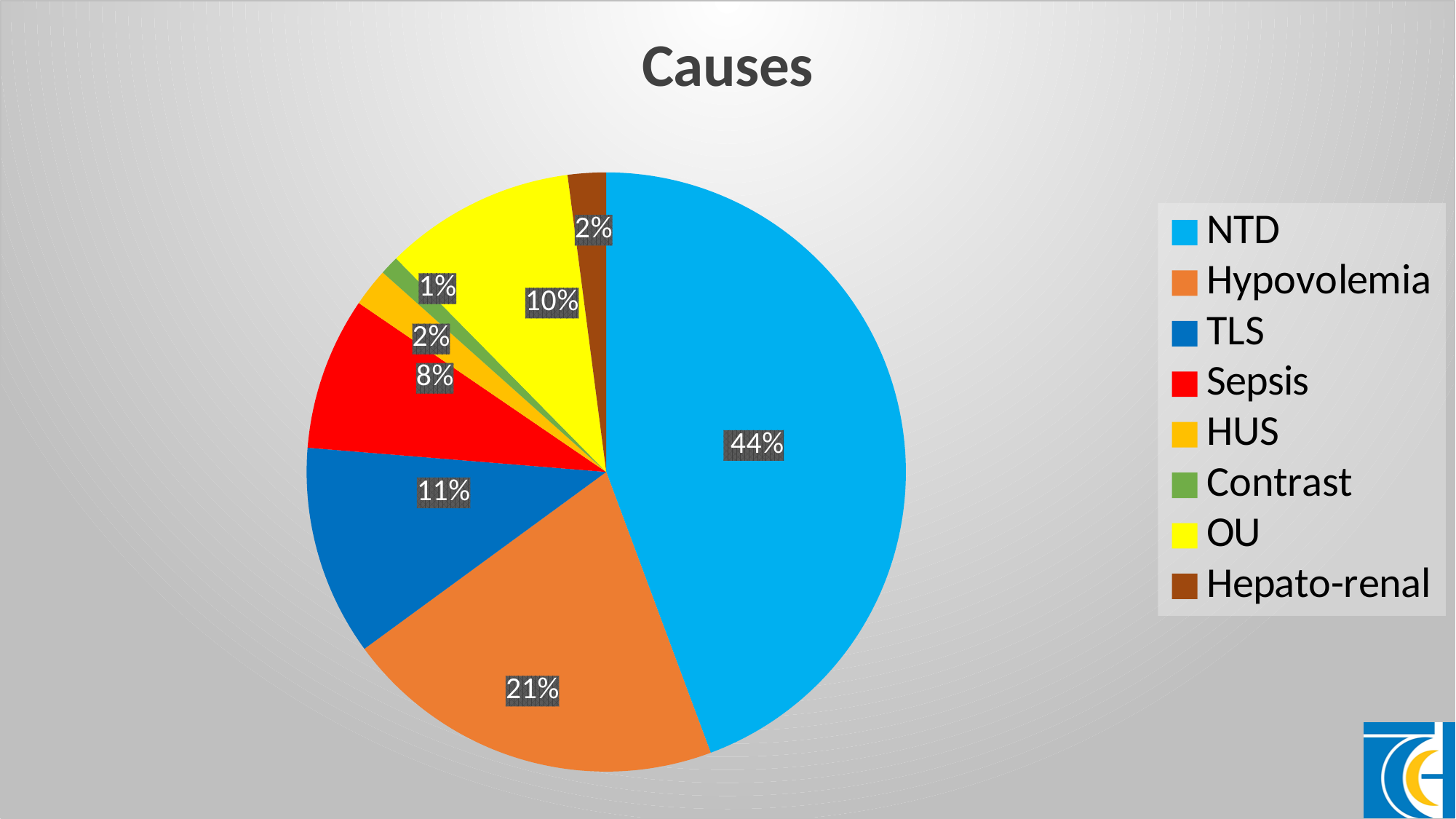
What type of chart is shown on the slide? pie chart What is the title of the chart? Causes What percentage is shown for Hypovolemia? 21% What percentage is shown for TLS? 11% What percentage is shown for OU? 10% Which has a larger share, TLS or OU? TLS What share of the pie does NTD account for? 44% Which cause has the largest share of the pie? NTD Which cause has the smallest share of the pie? Contrast What percentage is shown for Sepsis? 8% What is the difference in percentage points between NTD and Hypovolemia? 23 How many categories does the legend list? 8